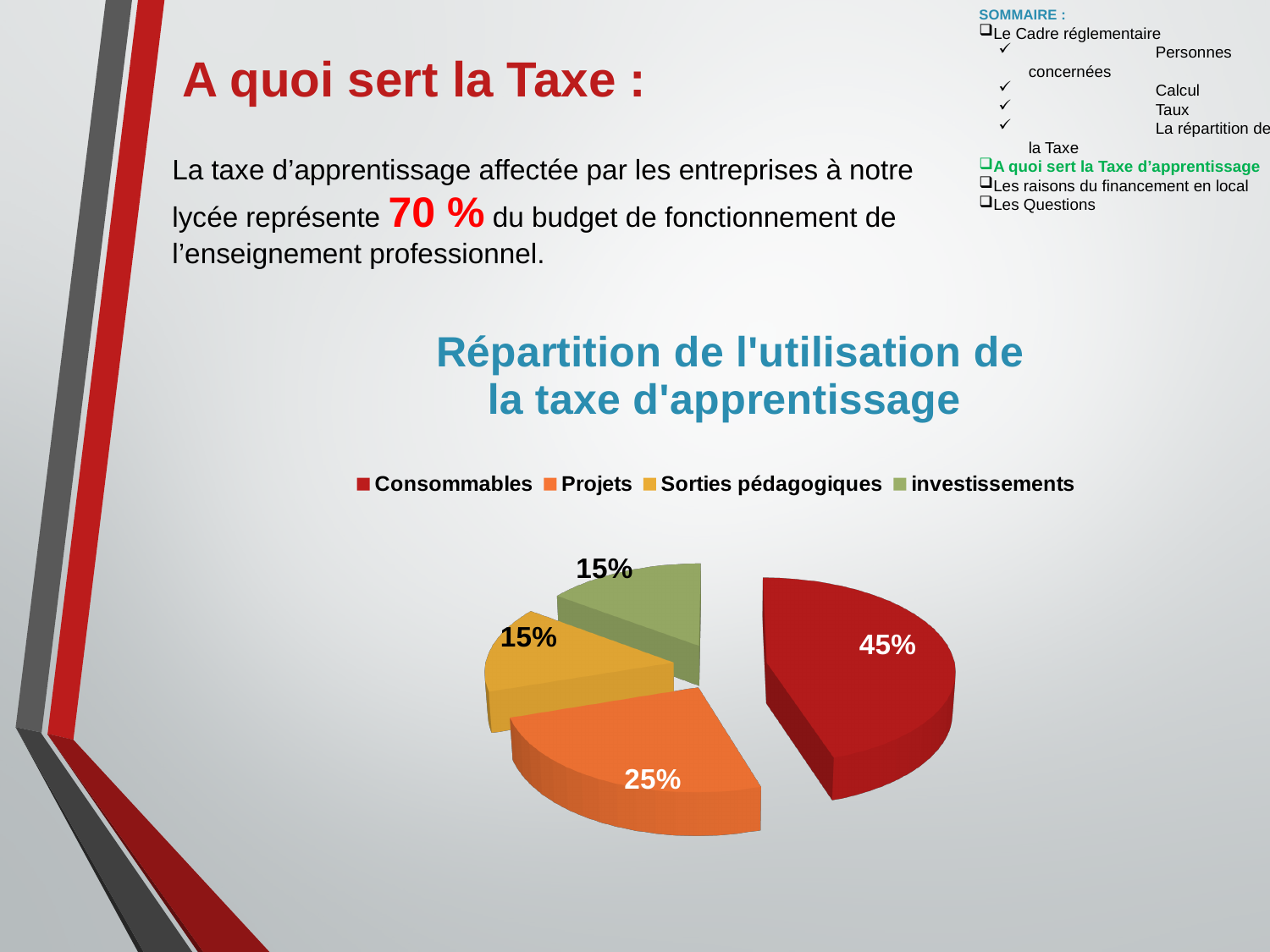
Which category has the largest slice of the pie? Consommables What kind of chart is shown on the slide? pie chart Which is larger, the slice for Consommables or the slice for Projets? Consommables What is the difference in percentage points between the Consommables slice and the Projets slice? 20% What share of the pie does Sorties pédagogiques represent? 15% What is the title of the chart? Répartition de l'utilisation de la taxe d'apprentissage What share of the pie does Consommables represent? 45% What share of the pie does investissements represent? 15% What is the difference in percentage points between the Projets slice and the investissements slice? 10% Which colour is used for the Consommables slice in the pie chart? red What share of the pie does Projets represent? 25% How many categories does the legend of the pie chart list? 4